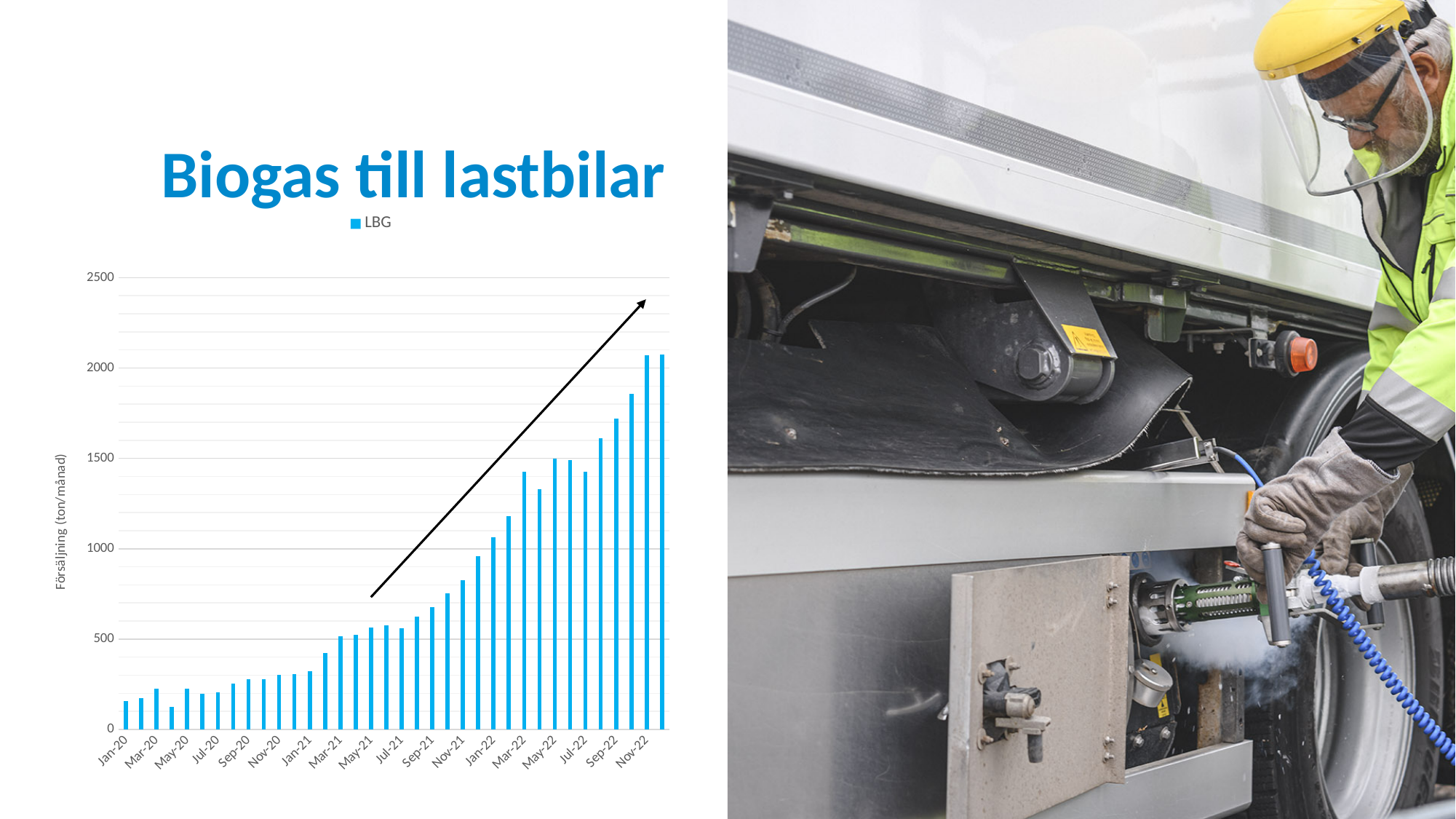
Is the value for Jul-22 greater or less than 1500? less What is the label on the vertical axis of the chart? Försäljning (ton/månad) Is the value for Jan-20 greater or less than 500? less What is the title of the chart? Biogas till lastbilar Is the value for Sep-22 greater or less than 1500? greater How many series does the chart legend list? 1 What kind of chart is shown on the slide? bar chart Which is larger, the value for Sep-22 or the value for Jul-22? Sep-22 Do the values generally rise or fall from Jan-20 to Nov-22? rise